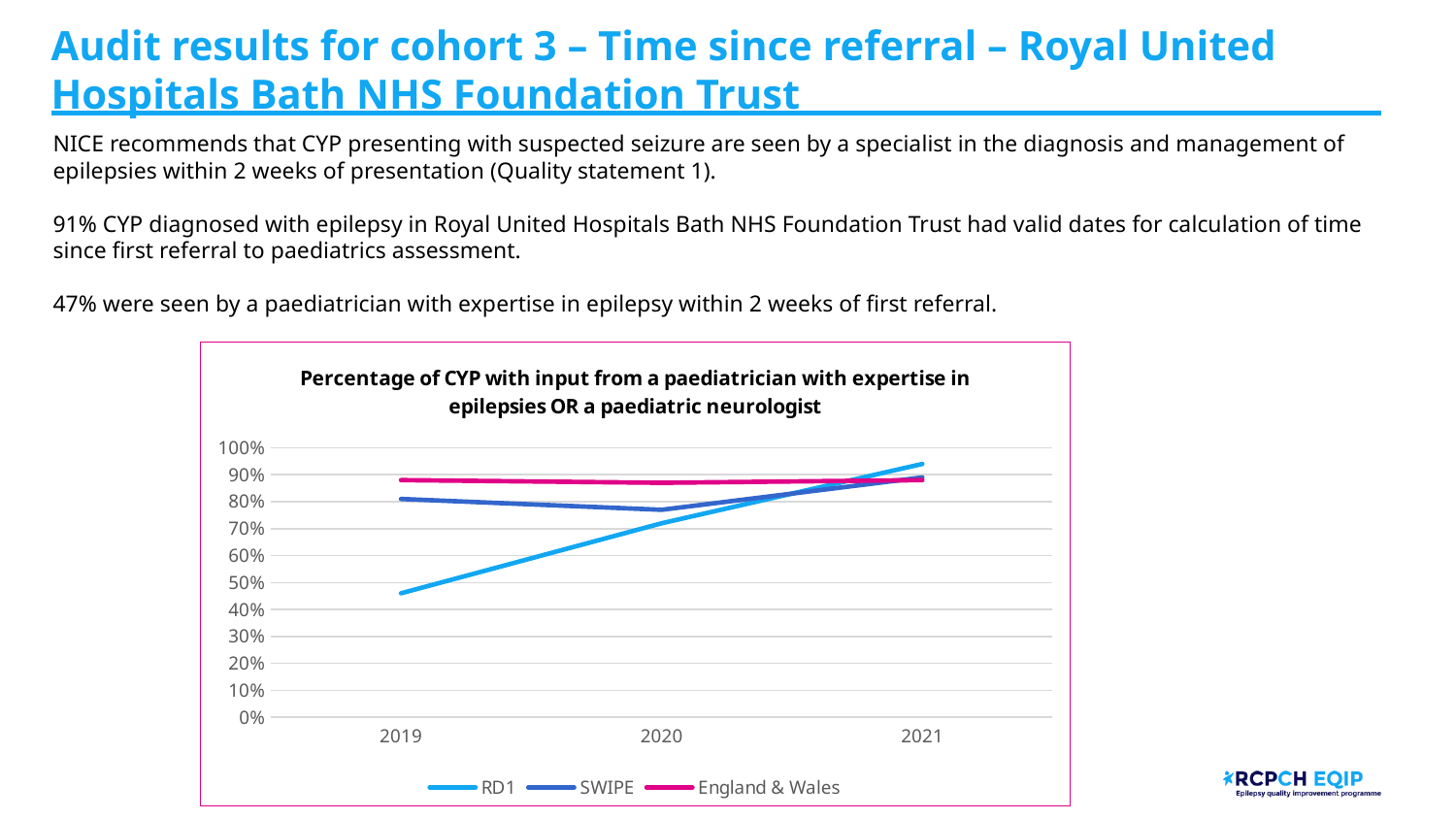
Which series is drawn in the pink/magenta line? England & Wales How many series does the chart legend list? 3 In which year is the RD1 value lowest? 2019 How many years are shown along the x axis of the chart? 3 Does the RD1 line rise or fall from 2019 to 2021? rise Is the value for RD1 in 2019 greater or less than 50%? less What kind of chart is shown on the slide? line chart In which year is the RD1 value highest? 2021 Is the value for England & Wales in 2019 greater or less than 80%? greater Is the value for SWIPE in 2020 greater or less than 80%? less In 2019, which is larger: the value for RD1 or the value for England & Wales? England & Wales